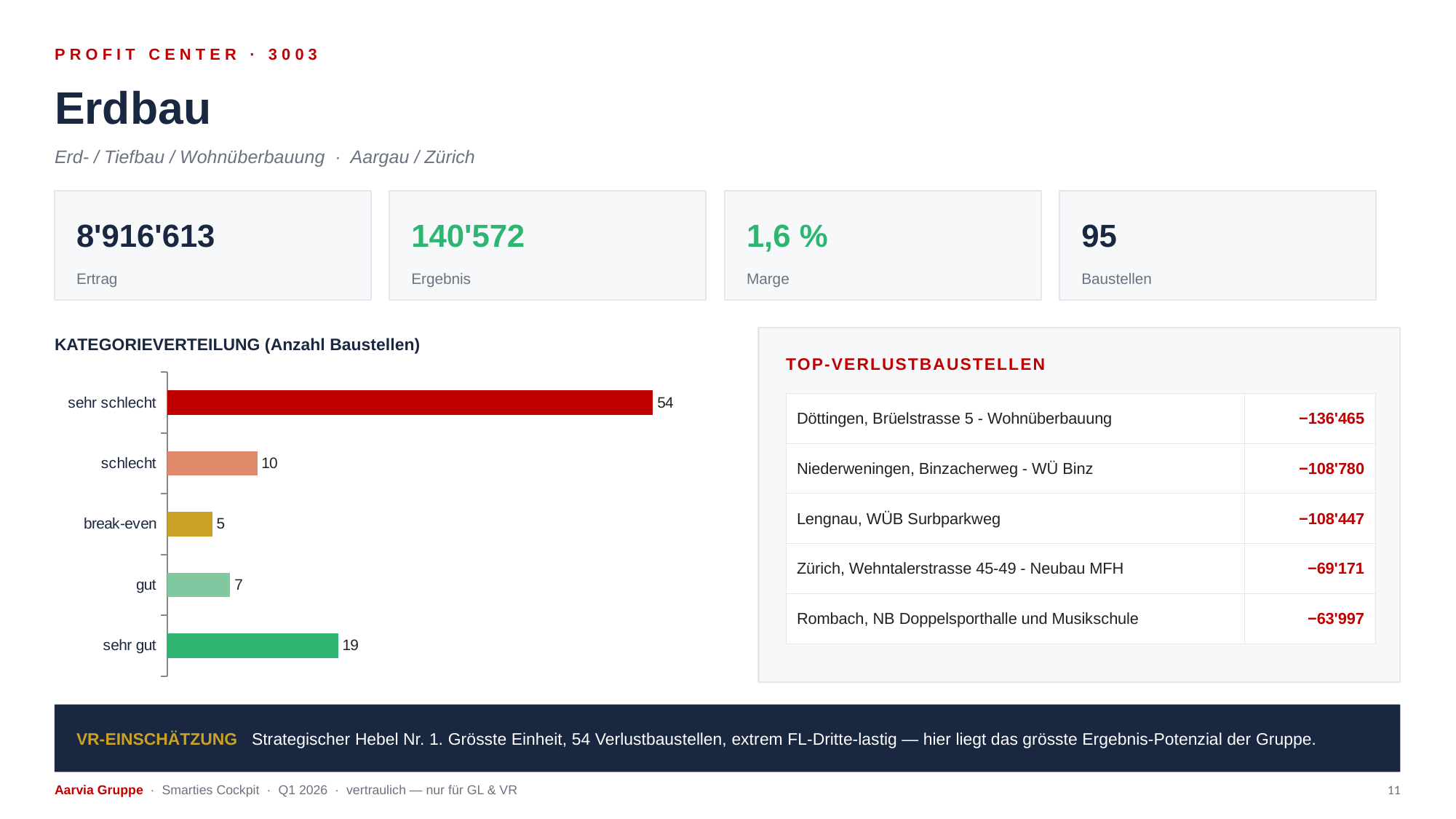
Which category has the lowest value in the Kategorieverteilung chart? break-even What is the title of the chart on the slide? KATEGORIEVERTEILUNG (Anzahl Baustellen) What is the difference between the values for 'sehr schlecht' and 'sehr gut' in the Kategorieverteilung chart? 35 What is the value for 'schlecht' in the Kategorieverteilung chart? 10 In the Kategorieverteilung chart, which is larger: the value for 'gut' or the value for 'break-even'? gut How many categories are shown in the Kategorieverteilung chart? 5 What is the value for 'sehr schlecht' in the Kategorieverteilung chart? 54 Which category has the highest value in the Kategorieverteilung chart? sehr schlecht What is the value for 'sehr gut' in the Kategorieverteilung chart? 19 What is the difference between the values for 'schlecht' and 'gut' in the Kategorieverteilung chart? 3 What is the value for 'break-even' in the Kategorieverteilung chart? 5 What kind of chart is the Kategorieverteilung chart? bar chart